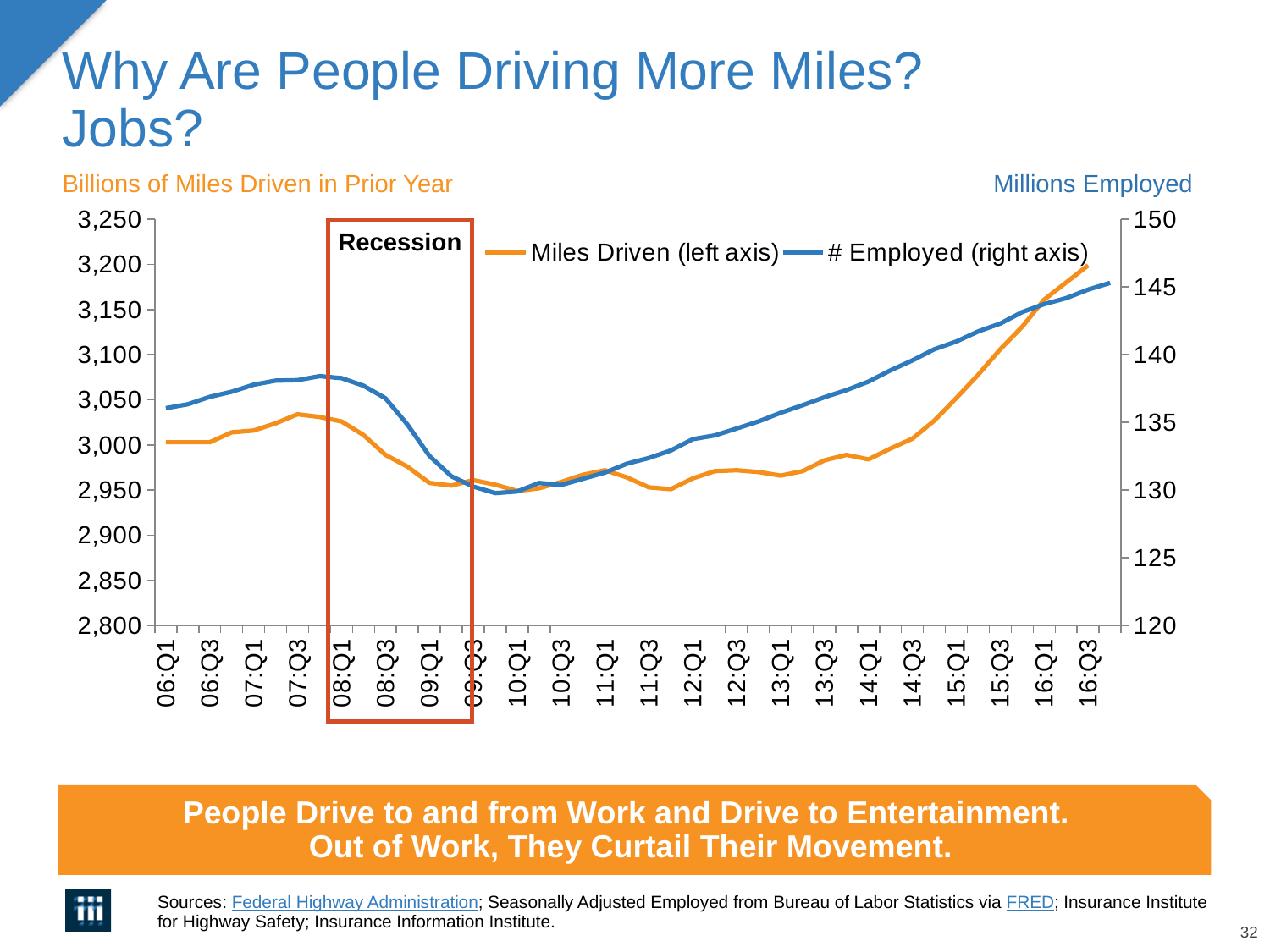
Which series is plotted against the right axis? # Employed At which quarter does the Miles Driven series reach its highest value? 16:Q3 What label is shown in the red box on the chart? Recession Does the Miles Driven series rise or fall from 14:Q1 to 16:Q3? rise How many series does the chart legend list? 2 At which quarter does the # Employed series reach its highest value? 16:Q4 Is the # Employed value at 16:Q3 greater or less than 140? greater Is the # Employed value at 06:Q1 greater or less than 140? less What kind of chart is shown on the slide? line chart Is the Miles Driven value at 16:Q3 greater or less than 3,150? greater Does the # Employed series rise or fall from 08:Q1 to 09:Q3? fall